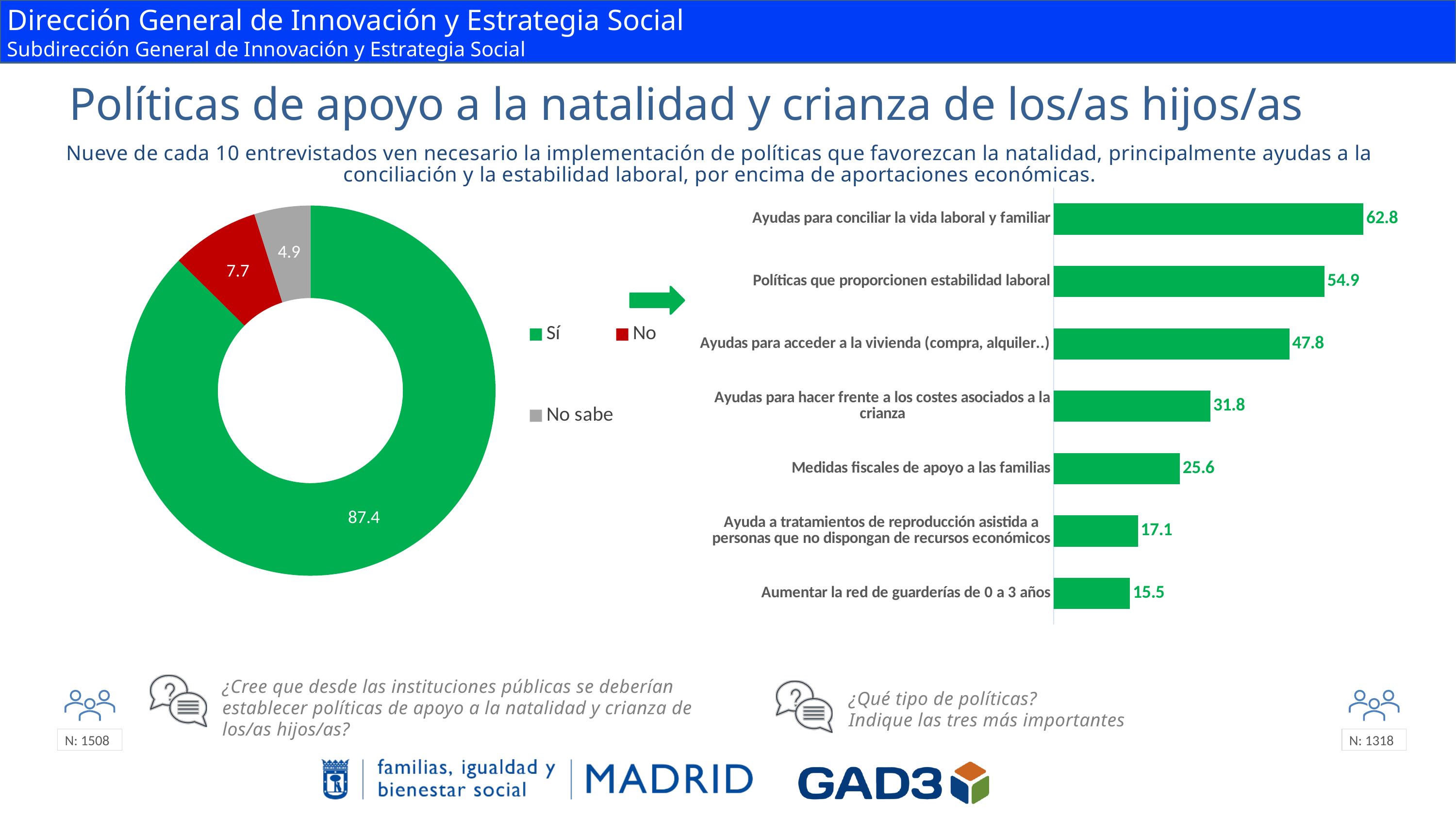
In the doughnut chart on the left, which category has the smallest value? No sabe In the doughnut chart on the left, what is the value for "No sabe"? 4.9 In the bar chart on the right, what is the value for "Políticas que proporcionen estabilidad laboral"? 54.9 In the bar chart on the right, what is the difference between "Ayudas para conciliar la vida laboral y familiar" and "Ayudas para acceder a la vivienda (compra, alquiler..)"? 15.0 In the bar chart on the right, which category has the highest value? Ayudas para conciliar la vida laboral y familiar In the bar chart on the right, how many categories are plotted? 7 In the doughnut chart on the left, what is the difference between the values for "No" and "No sabe"? 2.8 In the doughnut chart on the left, what colour is the "No" segment? Red In the bar chart on the right, which category has the lowest value? Aumentar la red de guarderías de 0 a 3 años In the doughnut chart on the left, how many categories does the legend list? 3 In the bar chart on the right, what is the value for "Medidas fiscales de apoyo a las familias"? 25.6 In the doughnut chart on the left, what is the value for "Sí"? 87.4